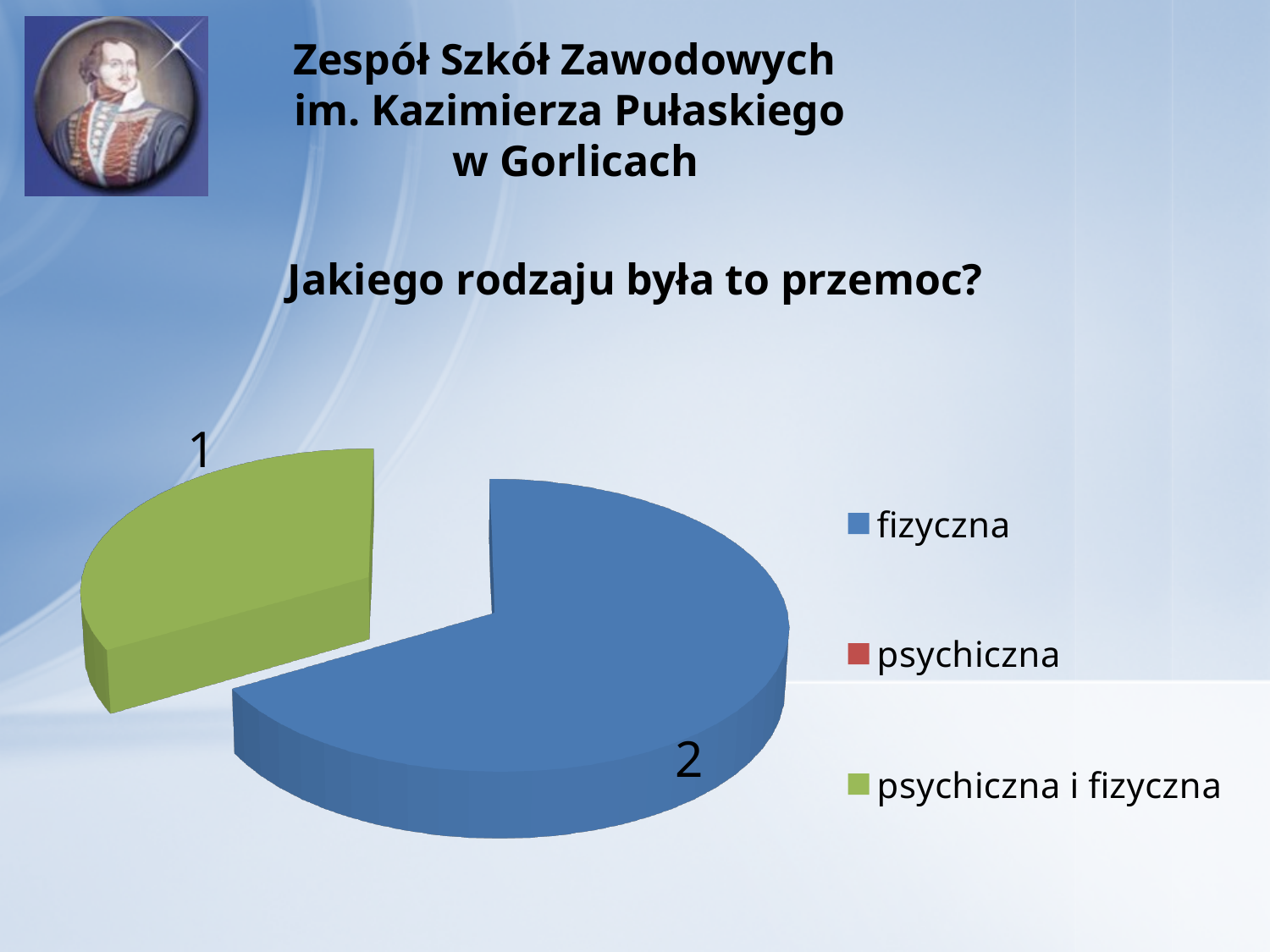
What kind of chart is shown on the slide? pie chart How many categories does the legend of the pie chart list? 3 What is the title of the chart on the slide? Jakiego rodzaju była to przemoc? Which is larger, the value for "fizyczna" or the value for "psychiczna i fizyczna"? fizyczna What value is shown for the "fizyczna" slice of the pie chart? 2 Which category has the largest slice in the pie chart? fizyczna What value is shown for the "psychiczna i fizyczna" slice of the pie chart? 1 What is the difference between the value for "fizyczna" and the value for "psychiczna i fizyczna"? 1 What colour is the "fizyczna" slice in the pie chart? blue